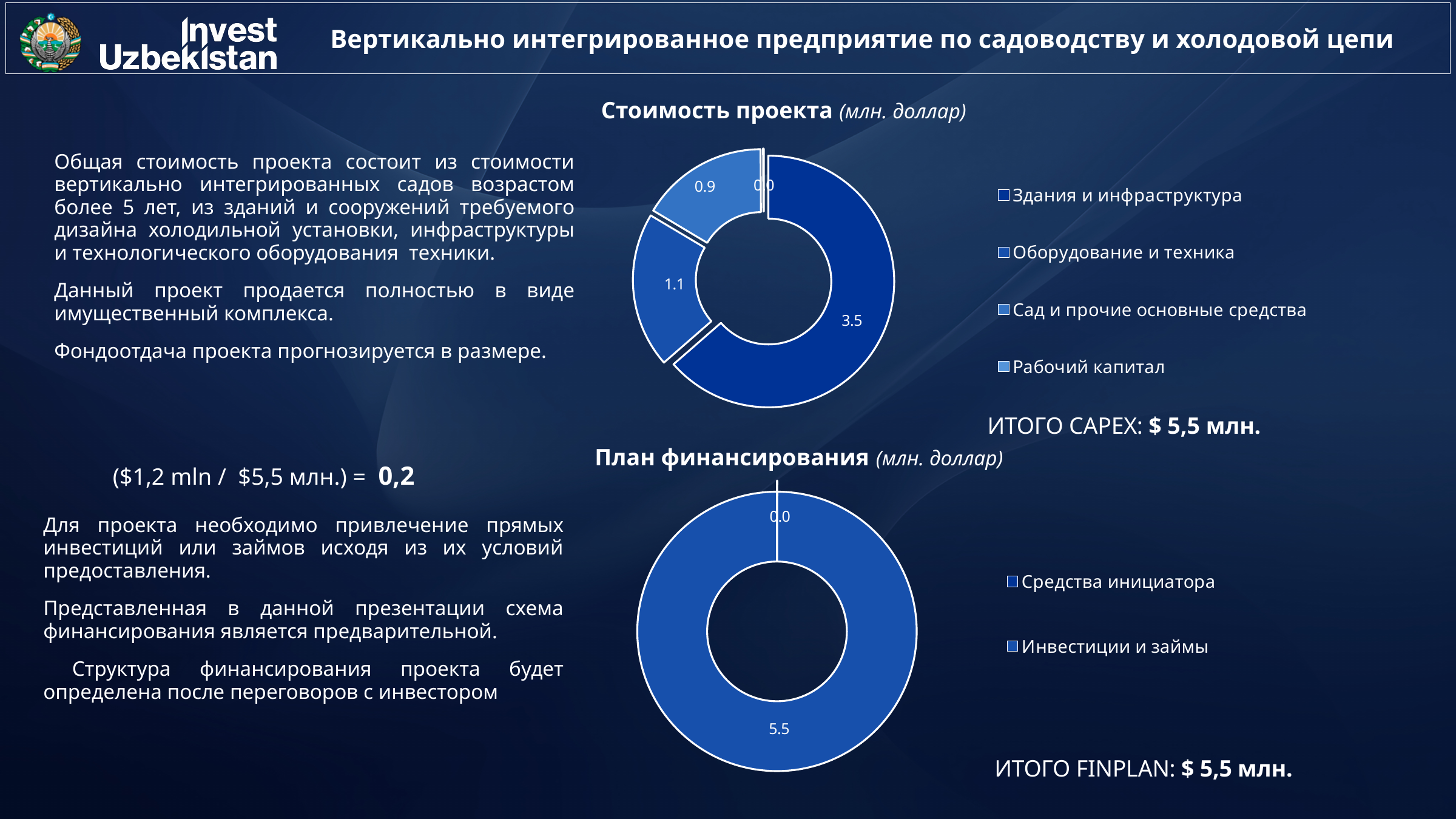
How many categories does the legend of the 'Стоимость проекта' chart list? 4 In the 'План финансирования' chart, what is the value for 'Средства инициатора'? 0.0 In the 'Стоимость проекта' chart, what is the value for 'Здания и инфраструктура'? 3.5 In what units are the values of the 'Стоимость проекта' chart given, according to its title? млн. доллар What is the total of all slice values in the 'Стоимость проекта' chart? 5.5 In the 'Стоимость проекта' chart, which is larger: the slice labelled 1.1 or the slice labelled 0.9? 1.1 How many categories does the legend of the 'План финансирования' chart list? 2 In the 'Стоимость проекта' chart, what is the largest value shown on a slice? 3.5 In the 'Стоимость проекта' chart, what is the difference between the largest slice (3.5) and the slice labelled 1.1? 2.4 In the 'План финансирования' chart, what is the value for 'Инвестиции и займы'? 5.5 What kind of chart is the 'Стоимость проекта' chart? Doughnut (pie) chart In the 'Стоимость проекта' chart, what is the smallest value shown on a slice? 0.0